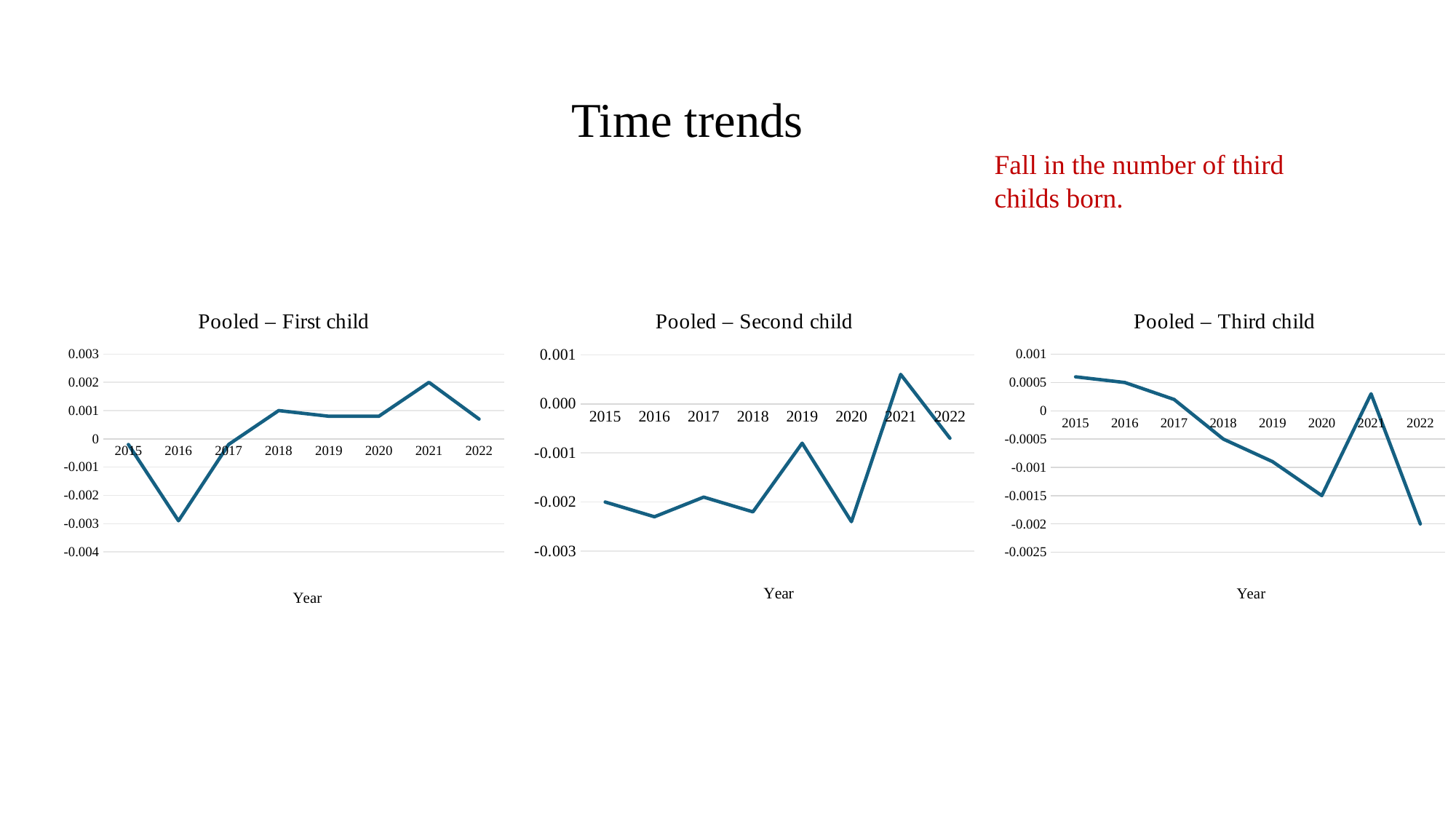
In the "Pooled – Second child" chart, which year has the highest value? 2021 In the "Pooled – First child" chart, what is the value for 2021? 0.002 In the "Pooled – Third child" chart, is the value for 2021 greater or less than 0? greater In the "Pooled – First child" chart, which year has the lowest value? 2016 In the "Pooled – Second child" chart, what is the value for 2015? -0.002 In the "Pooled – Third child" chart, does the value rise or fall from 2015 to 2020? fall In the "Pooled – Third child" chart, which year has the lowest value? 2022 In the "Pooled – Third child" chart, what is the value for 2020? -0.0015 What kind of chart is "Pooled – First child"? line chart In the "Pooled – Second child" chart, is the value for 2019 greater or less than -0.001? greater In the "Pooled – First child" chart, which year has the highest value? 2021 How many years are plotted on the x axis of the "Pooled – Third child" chart? 8